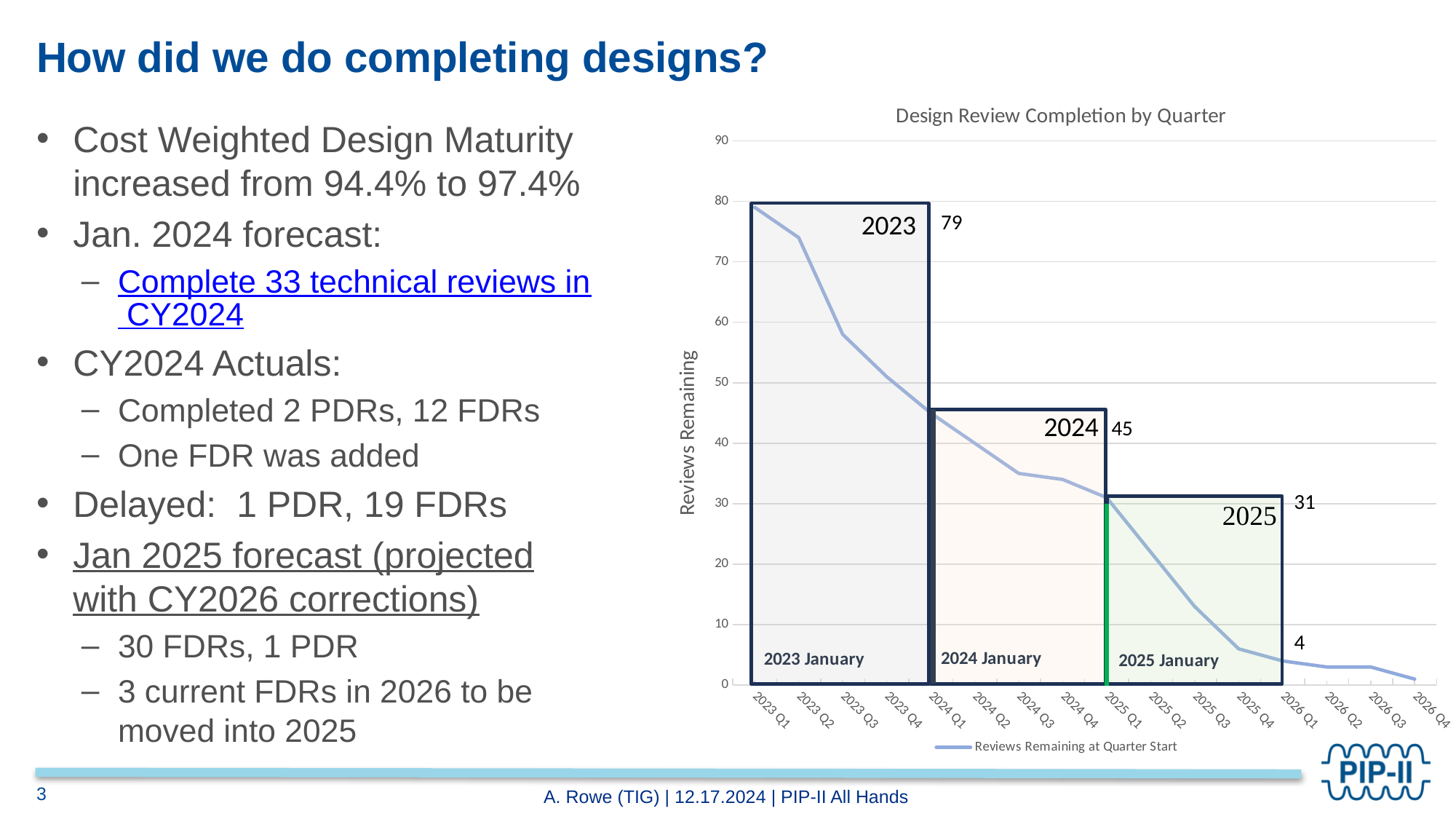
What kind of chart is shown on the slide? line chart What is the number of reviews remaining at the start of 2023 Q1? 79 What is the number of reviews remaining at the start of 2026 Q1? 4 How many series does the chart legend list? 1 By how much did the reviews remaining drop between the start of 2023 Q1 and the start of 2024 Q1? 34 Do the reviews remaining rise or fall across the quarters on the x axis? fall What is the name of the series shown in the chart legend? Reviews Remaining at Quarter Start What is the number of reviews remaining at the start of 2024 Q1? 45 What is the title of the chart? Design Review Completion by Quarter How many quarters are shown along the x axis of the chart? 16 What is the number of reviews remaining at the start of 2025 Q1? 31 Is the value for 2024 Q3 greater or less than 40? less